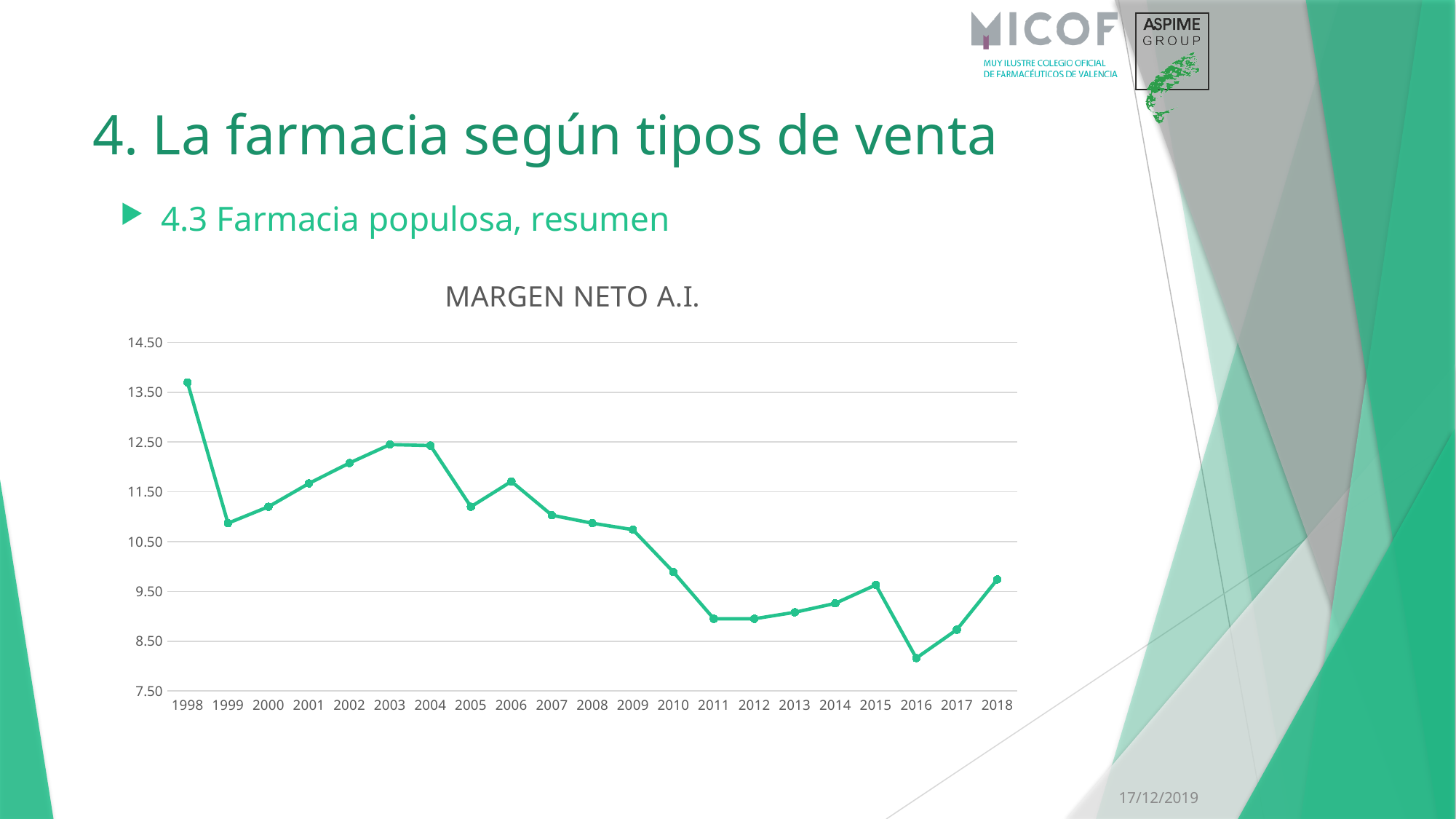
Is the value for 2016 greater or less than 8.50? less Which year has the larger value, 2003 or 2005? 2003 Overall, do the values rise or fall from 1998 to 2018? fall How many years are plotted on the x axis of the chart? 21 What is the title of the chart? MARGEN NETO A.I. Which year has the lowest value in the chart? 2016 Which year has the larger value, 2015 or 2016? 2015 Is the value for 2005 greater or less than 11.50? less Which year has the highest value in the chart? 1998 What kind of chart is shown on the slide? line chart Is the value for 2011 greater or less than 9.50? less